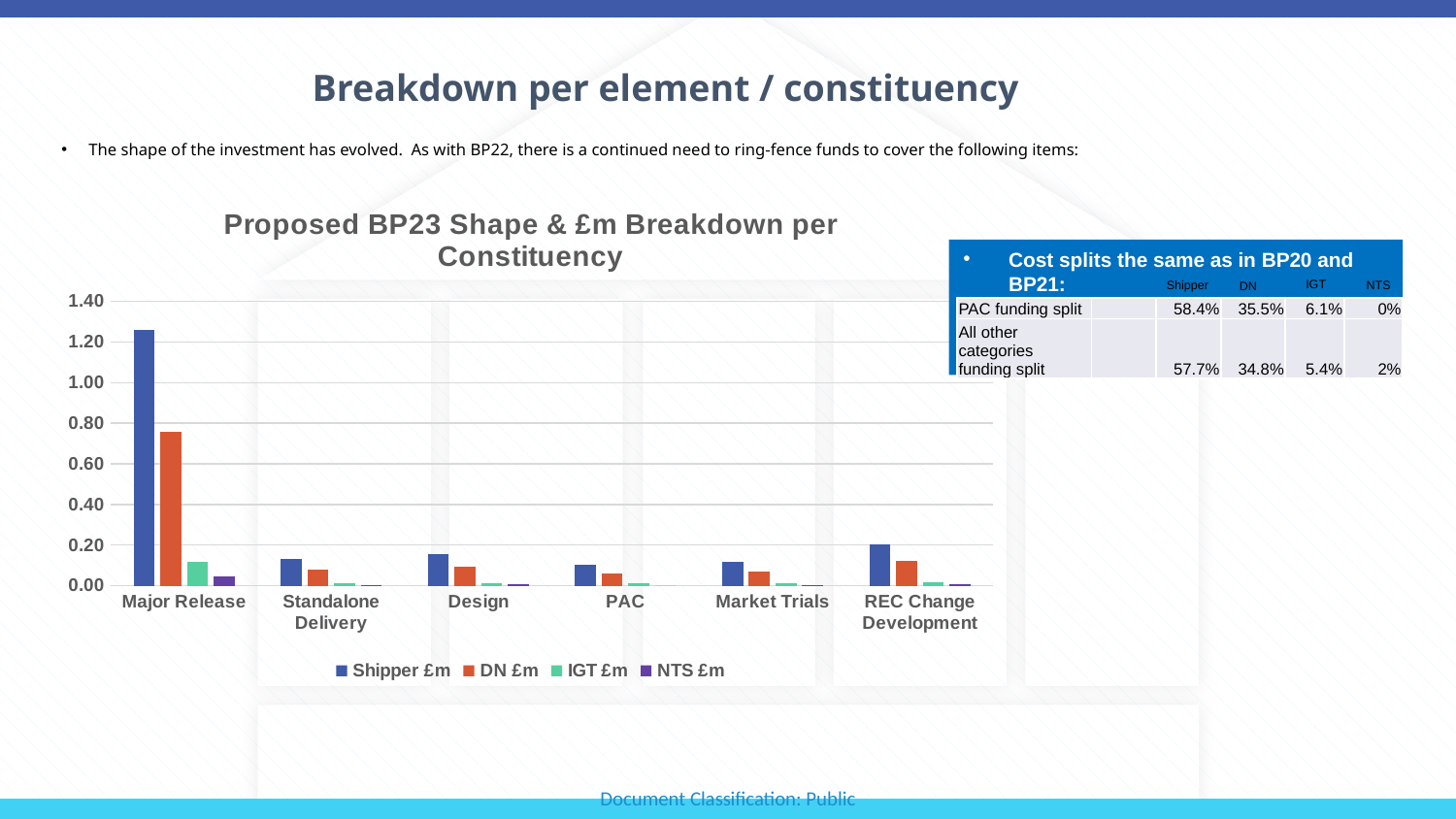
Which category has the highest Shipper £m value? Major Release How many series does the chart's legend list? 4 What is the title of the chart on the slide? Proposed BP23 Shape & £m Breakdown per Constituency Which series is shown in orange in the chart's legend? DN £m What type of chart is shown on the slide? bar chart Which category has the highest DN £m value? Major Release Is the Shipper £m value for Major Release greater or less than 1.00? greater How many categories are shown along the x axis of the chart? 6 Is the Shipper £m value for PAC greater or less than 0.20? less For Major Release, which is larger: the Shipper £m value or the DN £m value? Shipper £m Is the DN £m value for Major Release greater or less than 0.60? greater Which is larger: the Shipper £m value for REC Change Development or the Shipper £m value for Standalone Delivery? REC Change Development